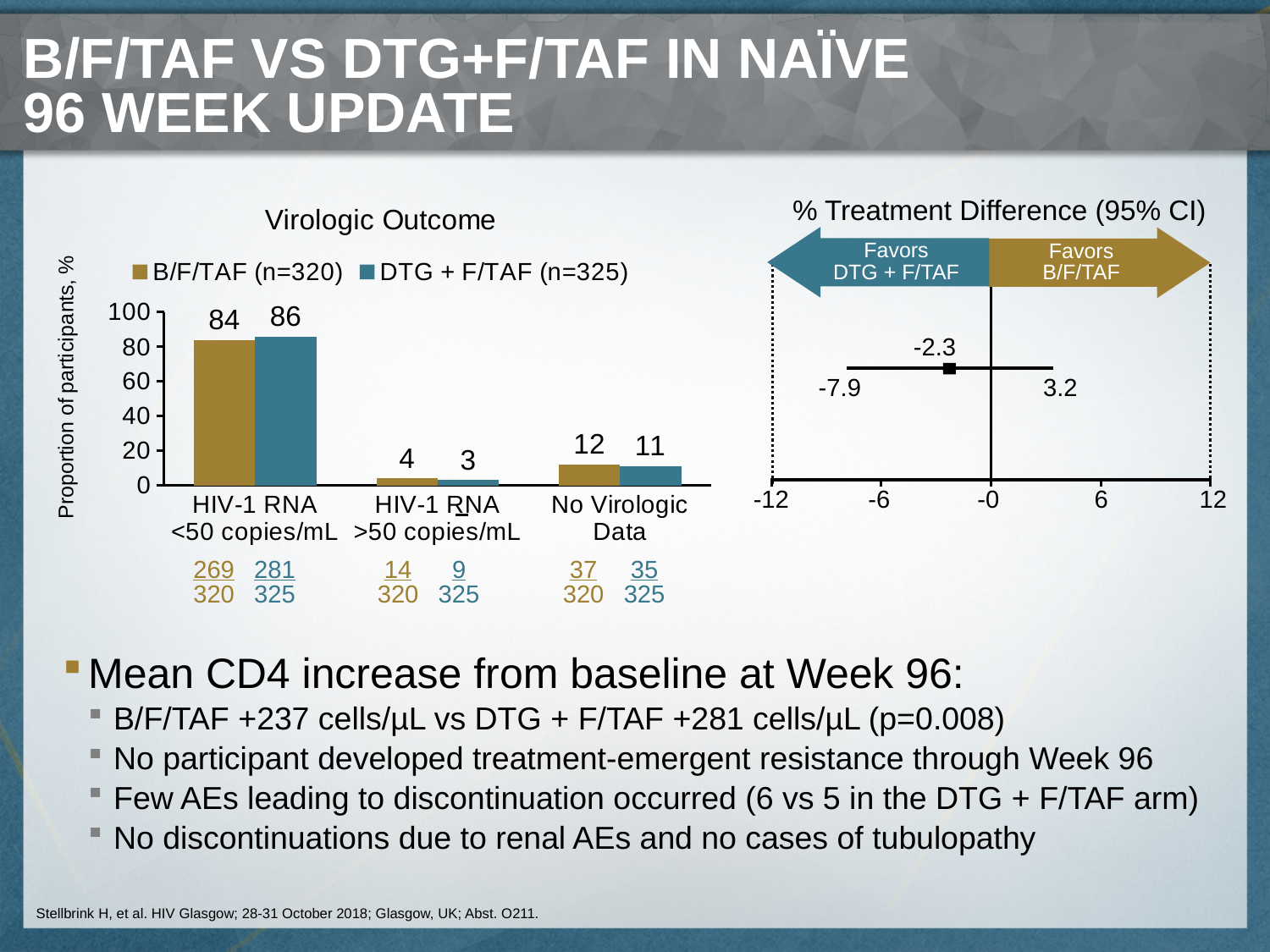
In the Virologic Outcome chart, how many series does the legend list? 2 In the Virologic Outcome chart, which category has the highest value for B/F/TAF? HIV-1 RNA <50 copies/mL In the Virologic Outcome chart, what is the value for DTG + F/TAF in the HIV-1 RNA >50 copies/mL category? 3 In the % Treatment Difference (95% CI) chart, what is the point estimate of the treatment difference? -2.3 In the Virologic Outcome chart, what is the value for DTG + F/TAF in the No Virologic Data category? 11 In the Virologic Outcome chart, how many categories are shown on the x axis? 3 In the Virologic Outcome chart, which category has the lowest value for DTG + F/TAF? HIV-1 RNA >50 copies/mL In the Virologic Outcome chart, what is the difference between the DTG + F/TAF and B/F/TAF values in the HIV-1 RNA <50 copies/mL category? 2 In the Virologic Outcome chart, what is the value for B/F/TAF in the HIV-1 RNA <50 copies/mL category? 84 What type of chart is the Virologic Outcome chart? Bar chart In the Virologic Outcome chart, which series has the larger value in the No Virologic Data category? B/F/TAF In the % Treatment Difference (95% CI) chart, what are the lower and upper bounds of the confidence interval? -7.9 and 3.2